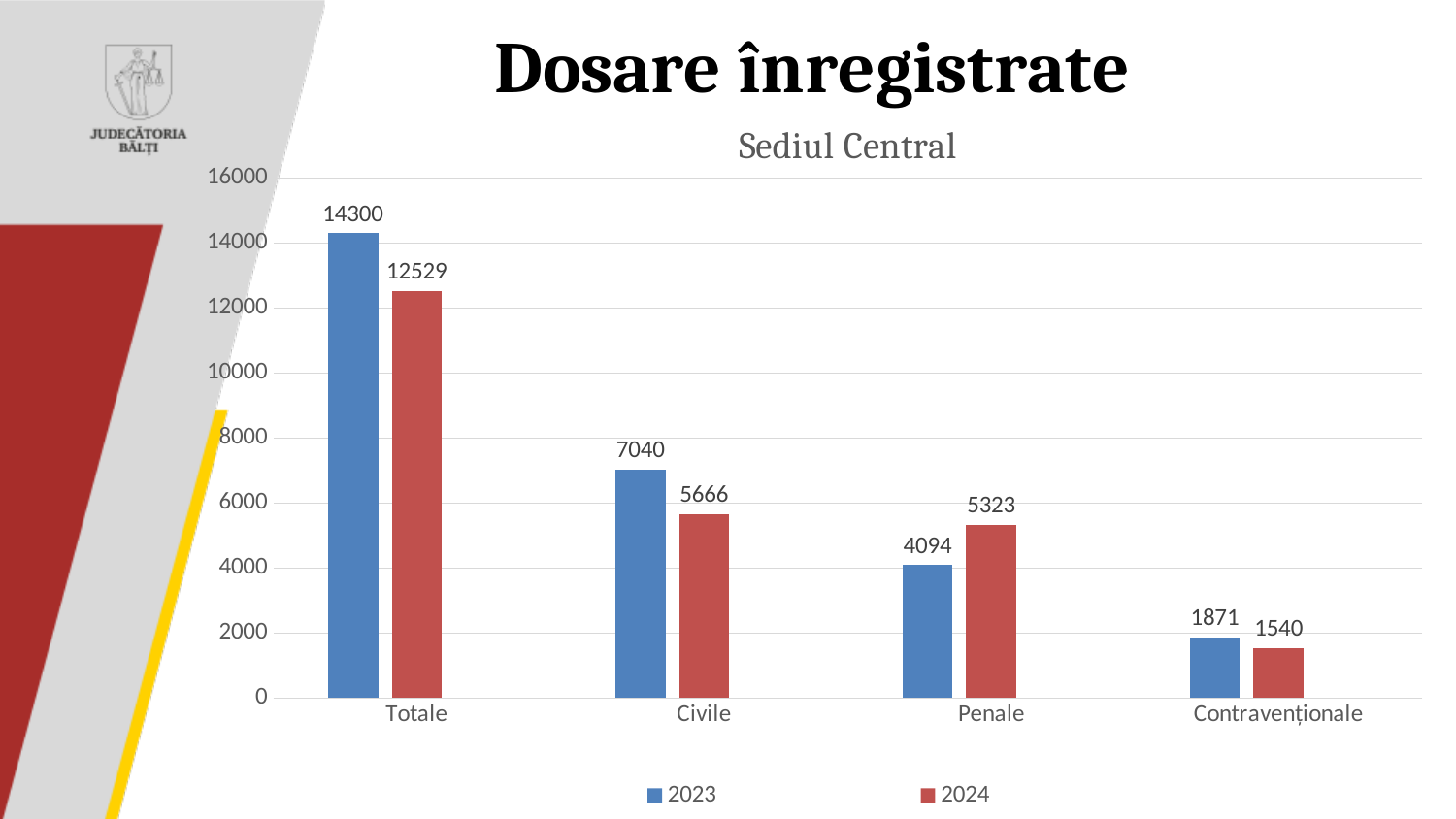
Which category has the highest value in 2023? Totale What is the value for Contravenționale in 2023? 1871 Which is larger for Penale, the 2023 value or the 2024 value? 2024 Is the 2024 value for Civile greater or less than 6000? less What is the value for Totale in 2023? 14300 What kind of chart is shown on the slide? bar chart What is the value for Penale in 2024? 5323 How many categories are shown on the x axis? 4 How many series does the legend list? 2 What is the difference between the 2023 and 2024 values for Totale? 1771 Which category has the lowest value in 2024? Contravenționale What is the difference between the 2023 and 2024 values for Civile? 1374